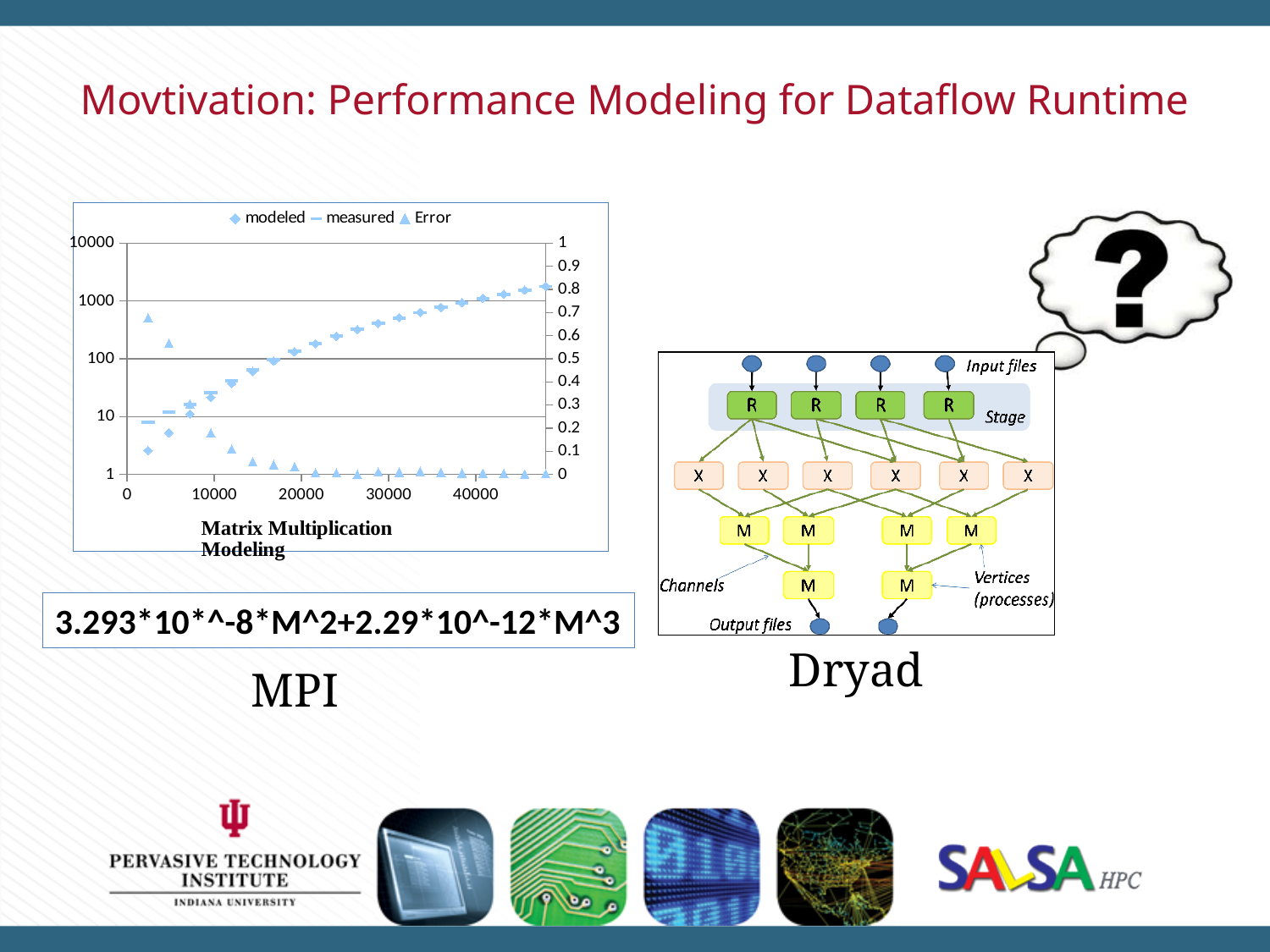
Is the modeled value at x = 10000 greater or less than 100 on the left axis? less What kind of chart is shown on the slide? scatter chart Is the Error value at x = 40000 greater or less than 0.1 on the right axis? less Do the modeled values rise or fall as the x-axis value increases? rise What is the highest tick value shown on the left vertical axis? 10000 What are the three series named in the chart legend? modeled, measured, Error Is the Error value at the smallest x value (around 2500) greater or less than 0.5 on the right axis? greater Which series has the larger value at x = 40000, modeled or Error (using their respective axes)? modeled Do the Error values rise or fall as the x-axis value increases? fall What caption is printed below the chart? Matrix Multiplication Modeling How many series does the chart legend list? 3